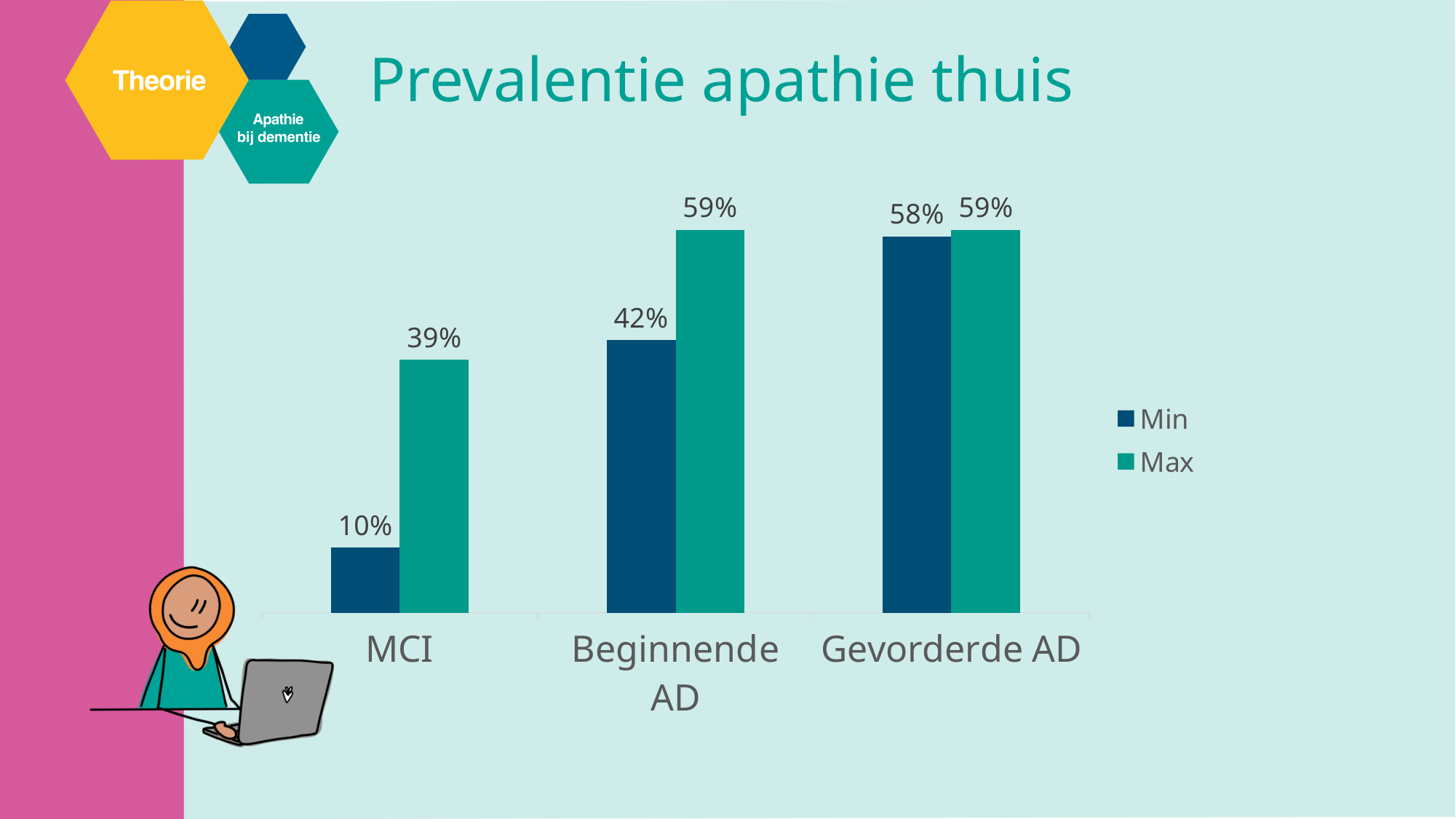
What is the Max value for Beginnende AD? 59% Which category has the highest Min value? Gevorderde AD How many categories are shown on the x axis? 3 What is the Min value for MCI? 10% What is the difference between the Max and Min values for Beginnende AD? 17% What is the Max value for MCI? 39% Which is larger, the Min value for Beginnende AD or the Max value for MCI? Min value for Beginnende AD What is the difference between the Max and Min values for MCI? 29% Which category has the lowest Min value? MCI What is the Min value for Gevorderde AD? 58% What kind of chart is shown on the slide? Bar chart How many series does the legend list? 2